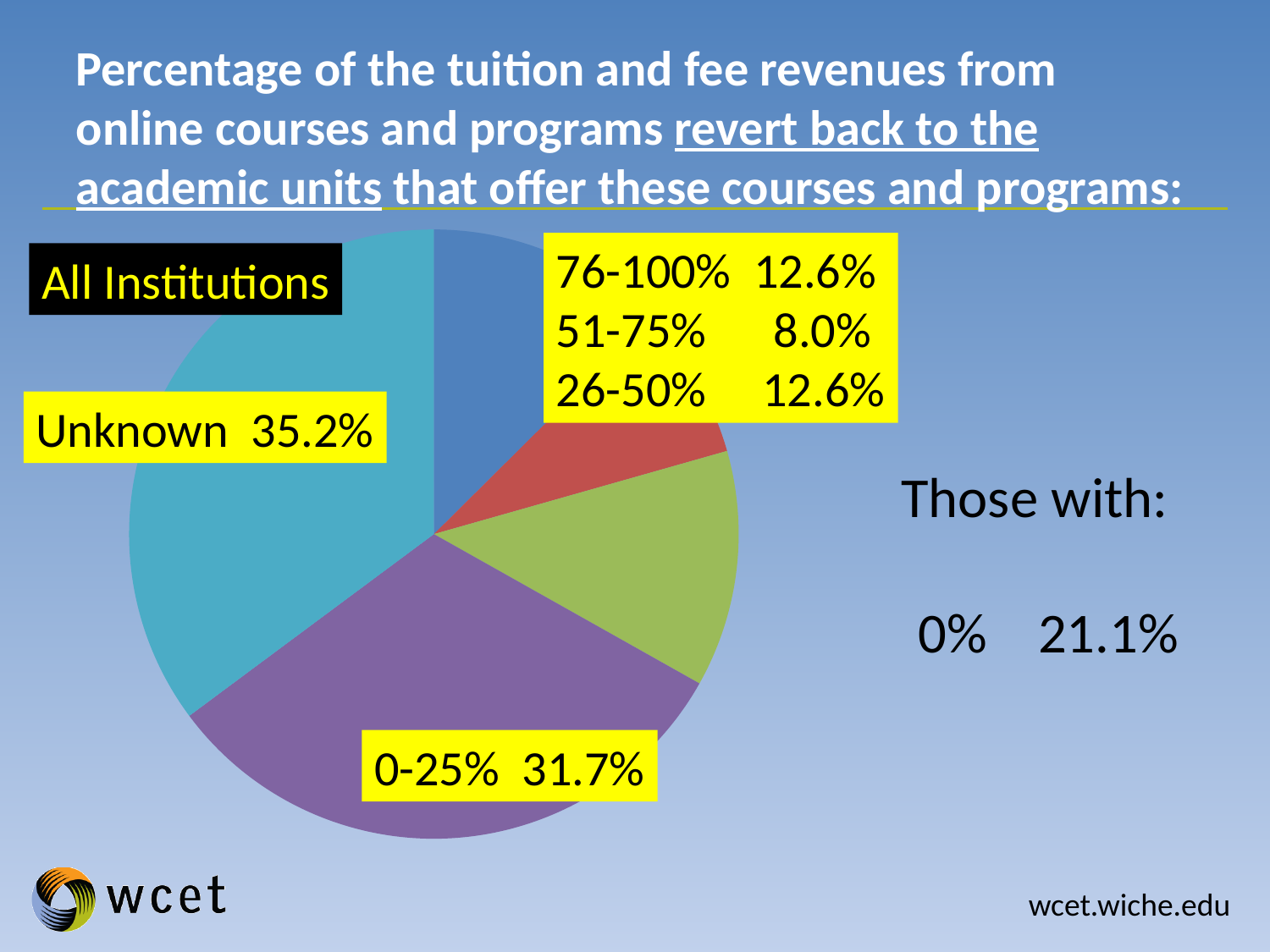
According to the text beside the chart, what percentage of institutions have 0% of revenues revert back to academic units? 21.1% What is the difference between the Unknown share and the 0-25% share? 3.5% What percentage is shown for the 0-25% category in the pie chart? 31.7% How many slices does the pie chart have? 5 Which category has the smallest slice of the pie chart? 51-75% What percentage is shown for the 76-100% category? 12.6% What percentage of institutions is labelled "Unknown" in the pie chart? 35.2% What percentage is shown for the 51-75% category? 8.0% Which is larger, the 0-25% slice or the 26-50% slice? 0-25% Which category has the largest slice of the pie chart? Unknown What kind of chart is shown on the slide? pie chart What percentage is shown for the 26-50% category? 12.6%